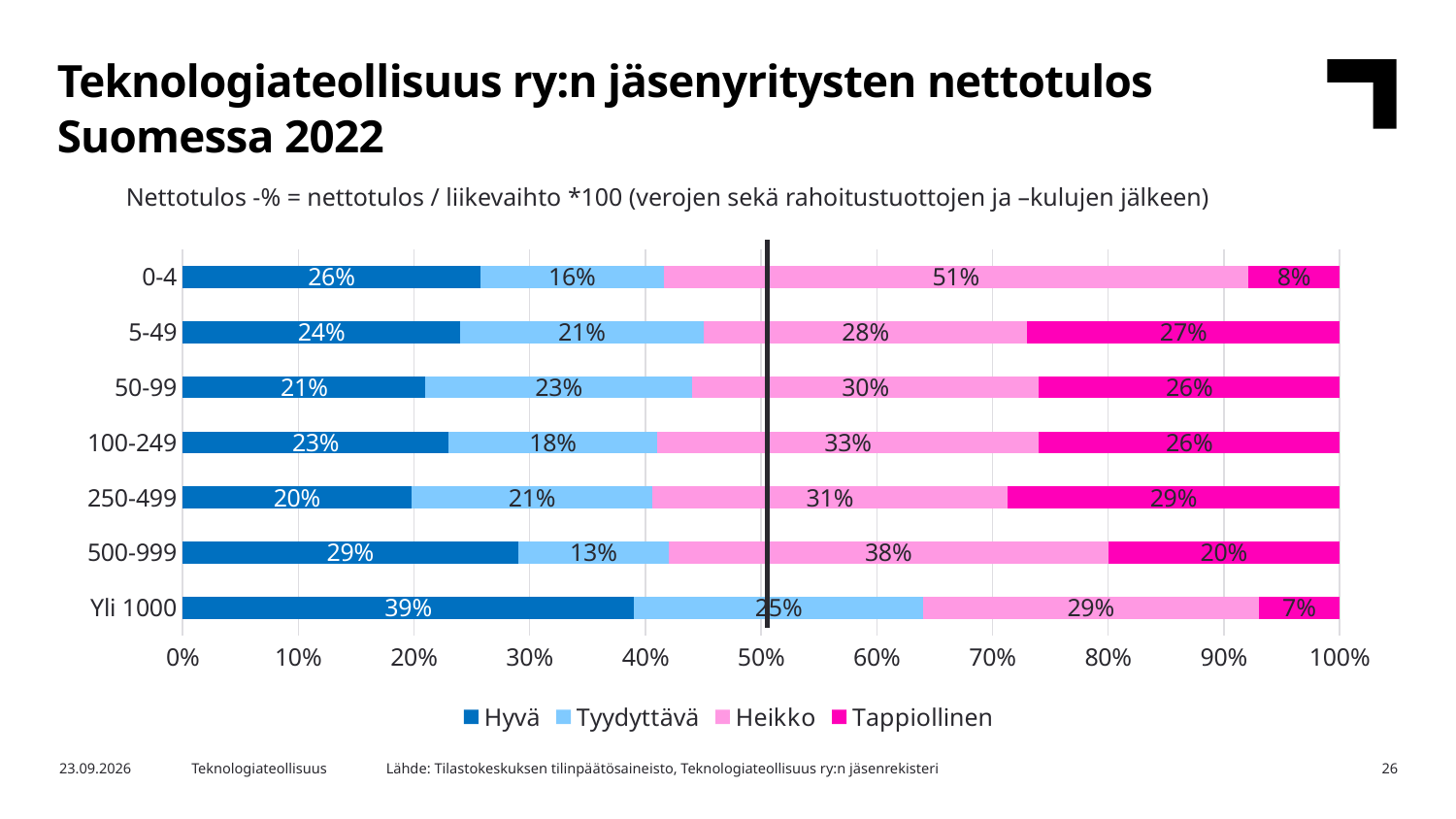
What is the Hyvä share for companies with over 1000 employees (Yli 1000)? 39% What kind of chart is shown on the slide? Stacked bar chart How many size classes are shown on the y axis? 7 What percentage of companies in the 0-4 size class had a Heikko (weak) net result? 51% How many series does the legend list? 4 Which is larger: the Tappiollinen share for 250-499 or for 500-999? 250-499 What is the combined share of Hyvä and Tyydyttävä for the 50-99 size class? 44% What is the Tyydyttävä share for the 500-999 size class? 13% Which size class has the highest Hyvä share? Yli 1000 Which size class has the lowest Tappiollinen share? Yli 1000 What is the difference between the Heikko share of the 0-4 class and the Heikko share of the 5-49 class? 23 percentage points What is the Tappiollinen share for the 5-49 size class? 27%